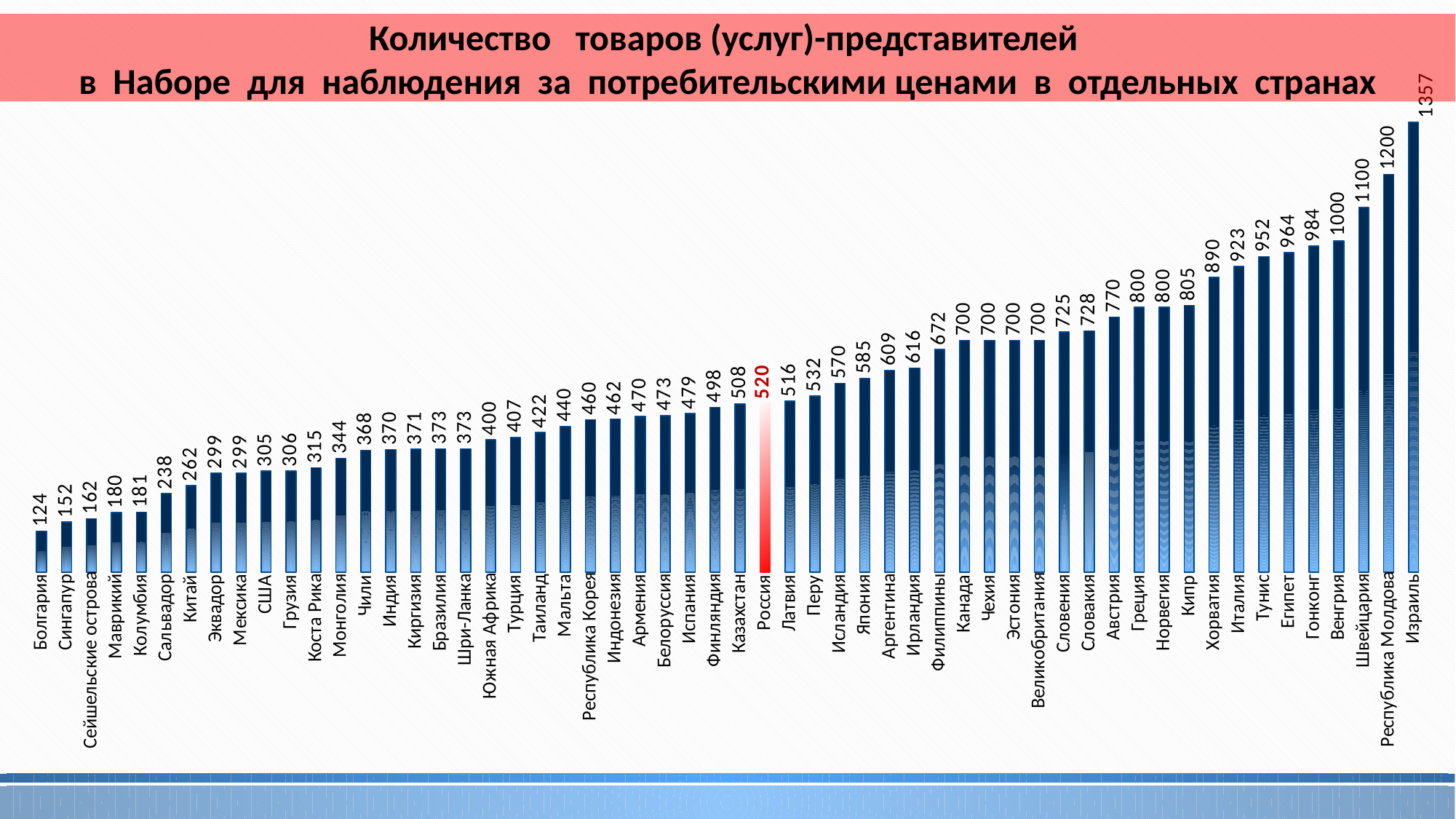
What is the value shown for Россия? 520 What kind of chart is shown on the slide? Bar chart Which country has the highest value on the chart? Израиль What is the value shown for Япония? 585 Do the values rise or fall from left to right along the x axis? Rise Which country has the lowest value on the chart? Болгария Which has a larger value, Китай or Сальвадор? Китай Which country's bar is highlighted in red? Россия What is the difference between the values for Россия and Казахстан? 12 What is the difference between the values for Израиль and Республика Молдова? 157 Which has a larger value, Италия or Хорватия? Италия What is the value shown for Швейцария? 1100